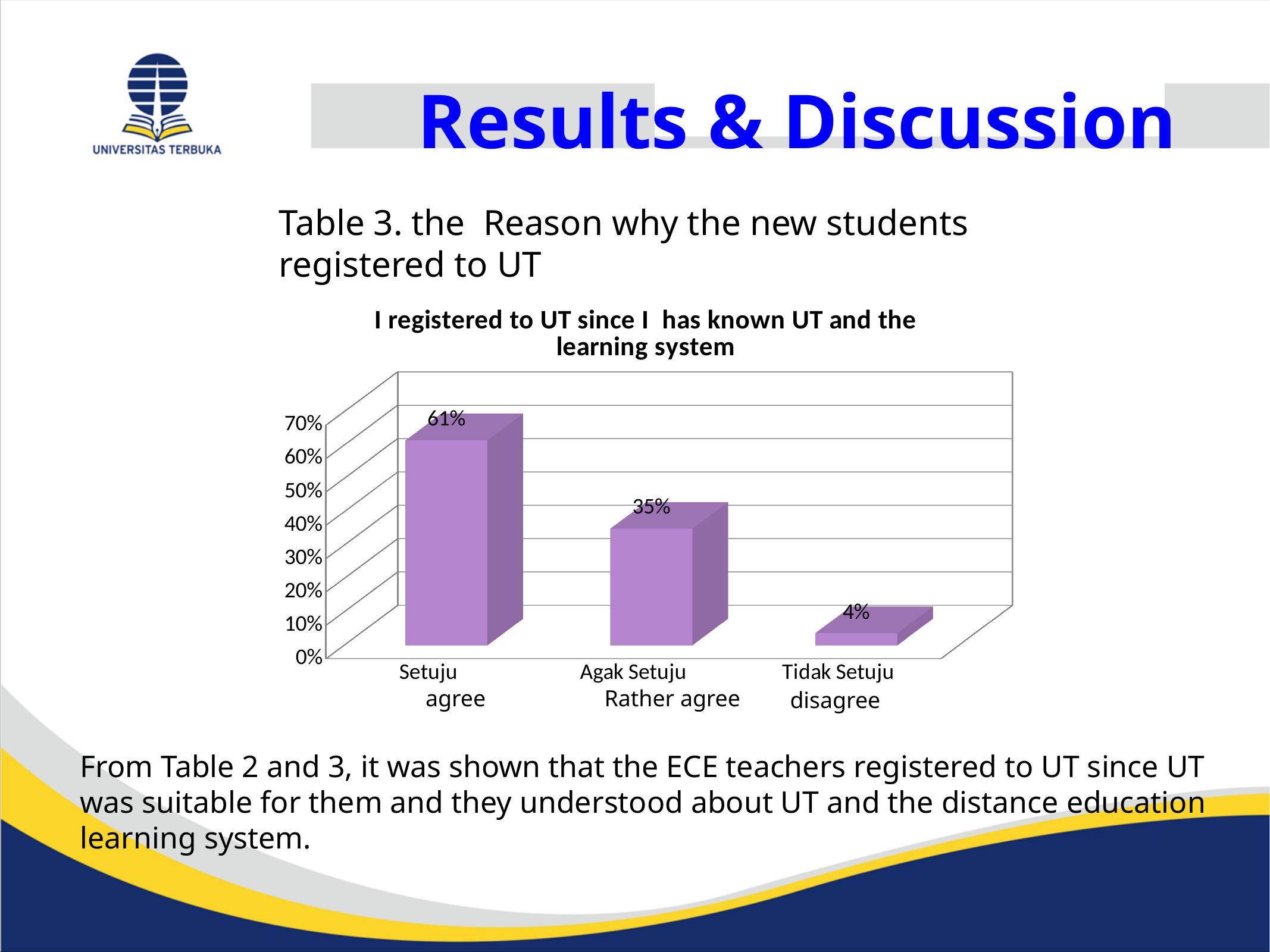
What is the difference between the values for Setuju and Agak Setuju? 26% Which is larger, the value for Agak Setuju or the value for Tidak Setuju? Agak Setuju What is the value for Agak Setuju (Rather agree)? 35% Which category has the lowest value? Tidak Setuju (disagree) What kind of chart is shown on the slide? Bar chart What is the value for Tidak Setuju (disagree)? 4% What is the value for Setuju (agree)? 61% How many categories are shown on the x axis? 3 What is the title of the chart? I registered to UT since I has known UT and the learning system Is the value for Setuju greater or less than 50%? greater Which category has the highest value? Setuju (agree) What is the difference between the values for Agak Setuju and Tidak Setuju? 31%